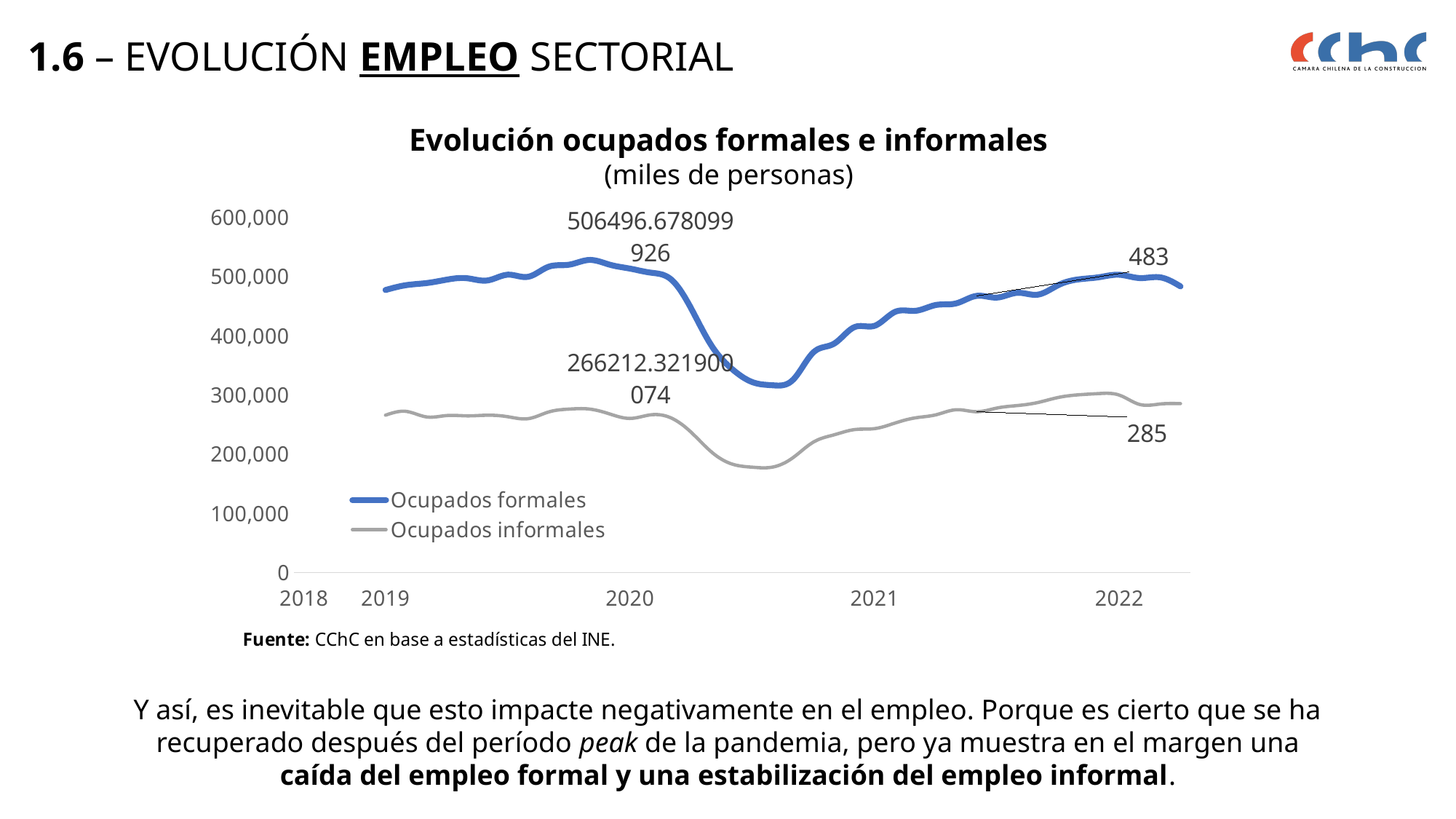
Is the lowest value of Ocupados formales during 2020 greater or less than 400,000? less What is the title of the chart? Evolución ocupados formales e informales What are the two series named in the legend? Ocupados formales and Ocupados informales Is the value for Ocupados formales at the start of 2019 greater or less than 400,000? greater Is the lowest value of Ocupados informales during 2020 greater or less than 200,000? less What is the last data label shown for Ocupados formales at the right end of the line? 483 What is the last data label shown for Ocupados informales at the right end of the line? 285 Which series has higher values throughout the chart, Ocupados formales or Ocupados informales? Ocupados formales How many series does the legend list? 2 What is the difference between the final labelled values of Ocupados formales (483) and Ocupados informales (285)? 198 What kind of chart is shown on the slide? line chart Do the values for Ocupados formales rise or fall between early 2020 and mid 2020? fall